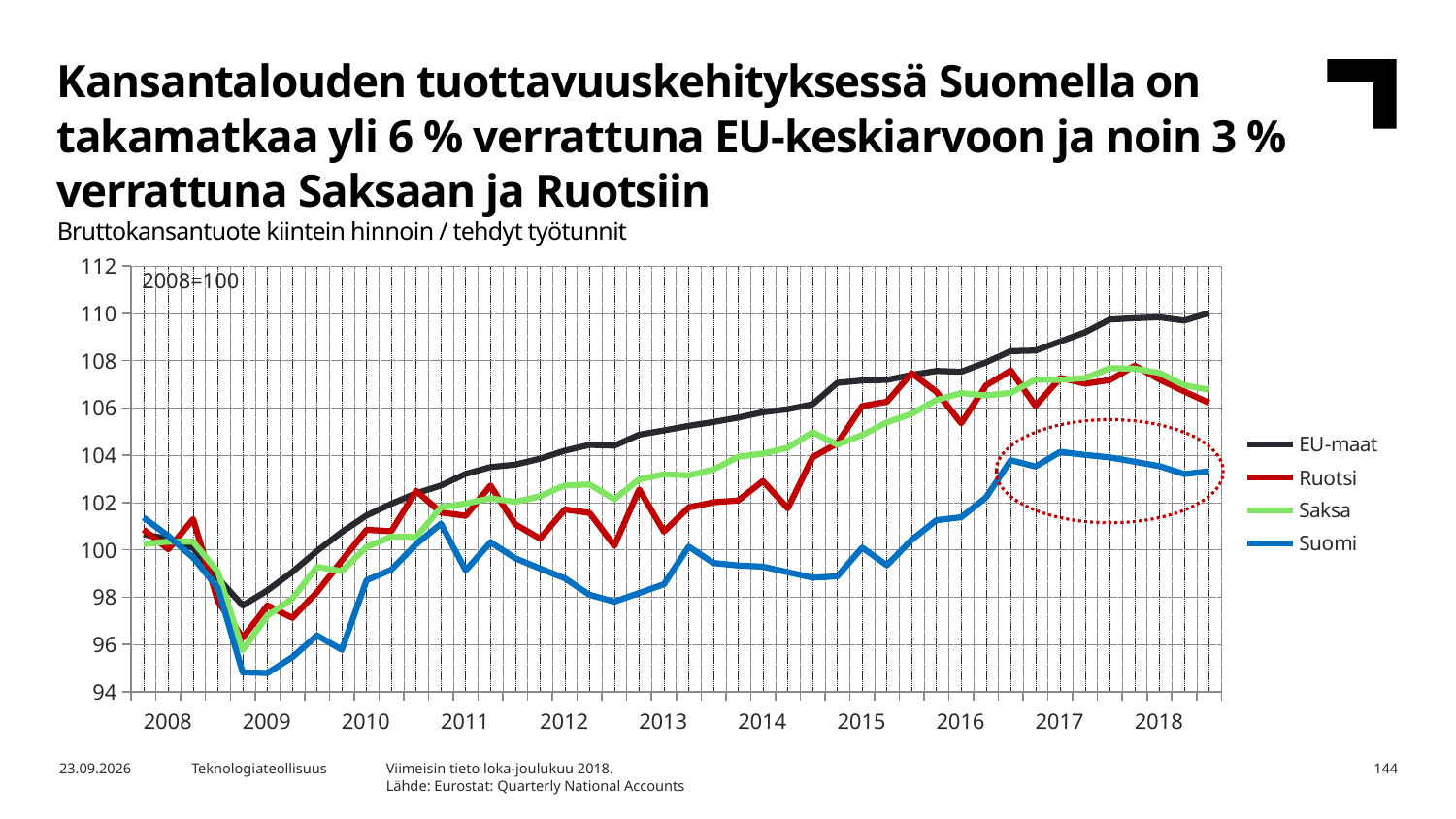
Which series are listed in the legend? EU-maat, Ruotsi, Saksa, Suomi How many series does the legend list? 4 Is the value for Suomi at the end of 2018 greater or less than 104? less What type of chart is shown on the slide? line chart Does the EU-maat series rise or fall from 2010 to 2018? rise How many year labels are shown on the x axis? 11 What base year and value is indicated on the chart? 2008=100 At the end of 2018, which is larger, Saksa or Suomi? Saksa Is the lowest value for Suomi in 2009 greater or less than 96? less Is the value for EU-maat at the end of 2018 greater or less than 108? greater Which series has the highest value at the end of 2018? EU-maat Which series has the lowest value at the end of 2018? Suomi